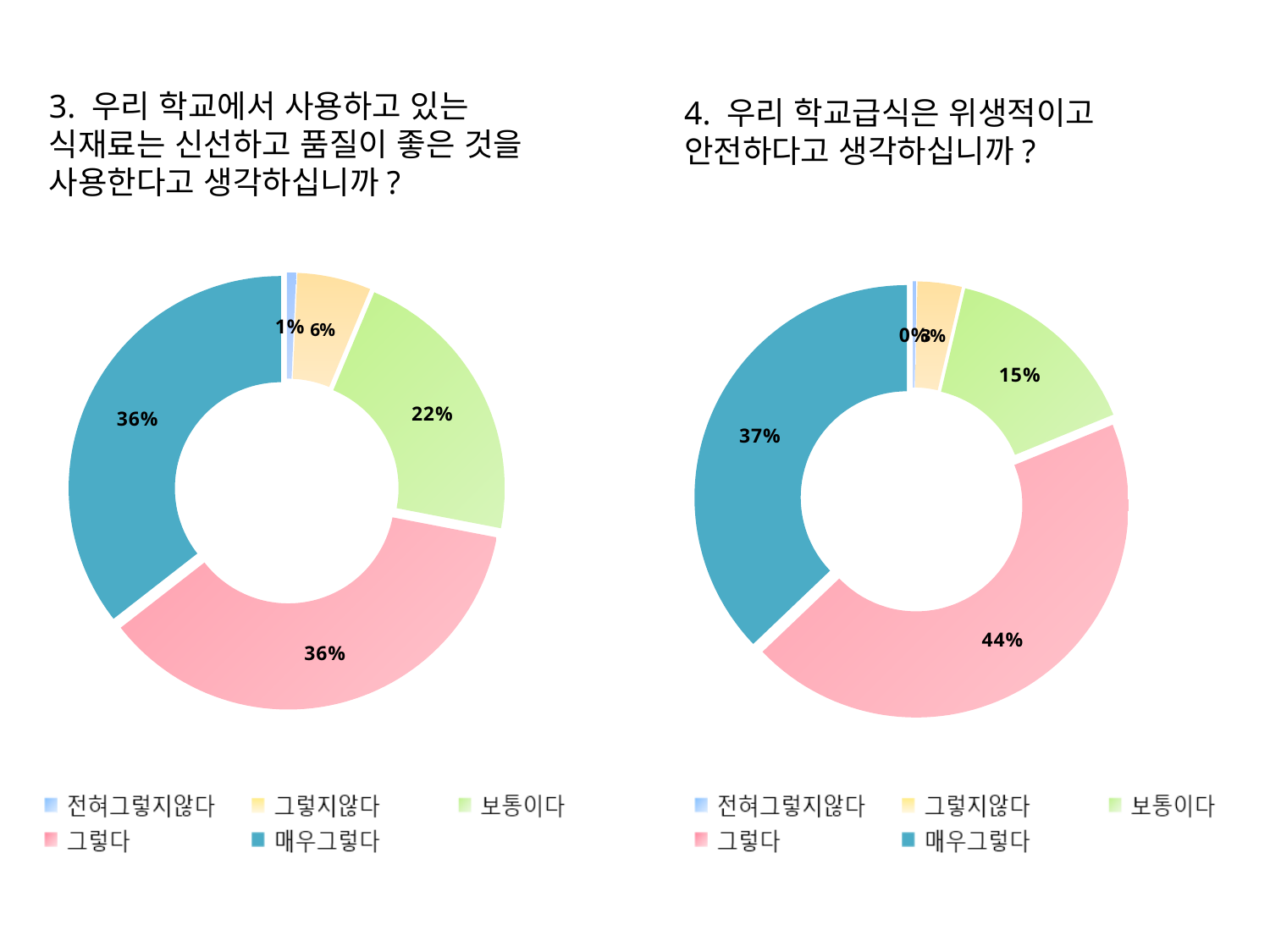
In the left chart (question 3), which is larger, the share for 보통이다 or the share for 그렇지않다? 보통이다 In the right chart (question 4), what percentage is shown for 그렇다? 44% What type of chart is used on the left side of the slide (question 3)? Pie chart (doughnut) In the left chart (question 3), what percentage is shown for 매우그렇다? 36% In the left chart (question 3), what percentage is shown for 그렇지않다? 6% In the left chart (question 3), what percentage is shown for 전혀그렇지않다? 1% In the right chart (question 4), which category has the smallest share? 전혀그렇지않다 In the left chart (question 3), what percentage is shown for 보통이다? 22% In the right chart (question 4), what percentage is shown for 매우그렇다? 37% In the right chart (question 4), which category has the largest share? 그렇다 In the right chart (question 4), what percentage is shown for 보통이다? 15% In the right chart (question 4), what is the difference between the shares for 그렇다 and 매우그렇다? 7%